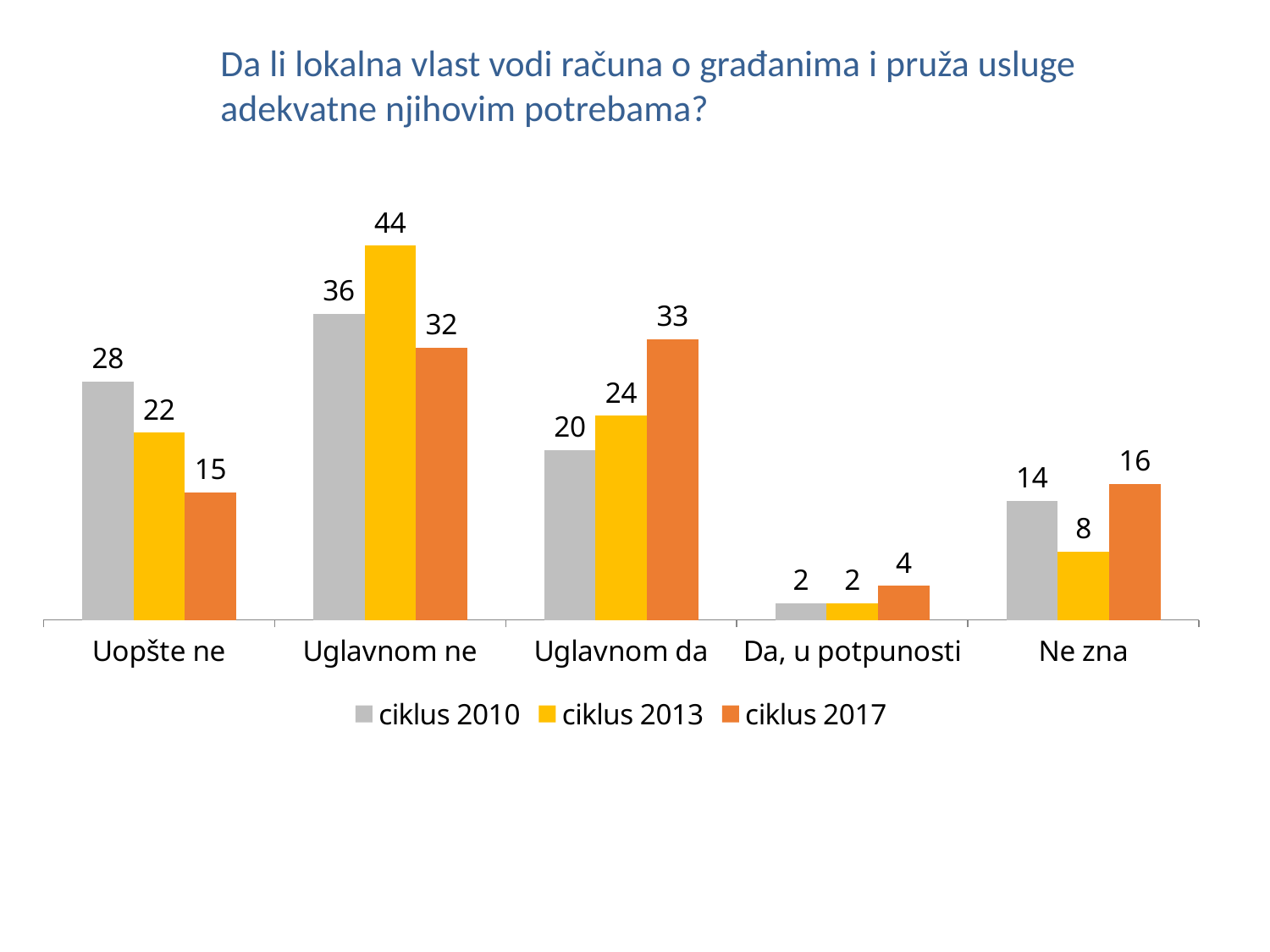
What is the difference between the ciklus 2017 and ciklus 2010 values for 'Uglavnom da'? 13 What is the difference between the ciklus 2013 and ciklus 2017 values for 'Uopšte ne'? 7 Which is larger for 'Ne zna': the ciklus 2010 value or the ciklus 2013 value? ciklus 2010 What kind of chart is shown on the slide? bar chart What is the value for 'Uglavnom ne' in the ciklus 2013 series? 44 What is the value for 'Ne zna' in the ciklus 2017 series? 16 Which series is shown in grey in the legend? ciklus 2010 Which category has the lowest value in the ciklus 2010 series? Da, u potpunosti How many categories are shown on the x axis? 5 Which category has the highest value in the ciklus 2017 series? Uglavnom da How many series does the legend list? 3 What is the value for 'Uopšte ne' in the ciklus 2010 series? 28